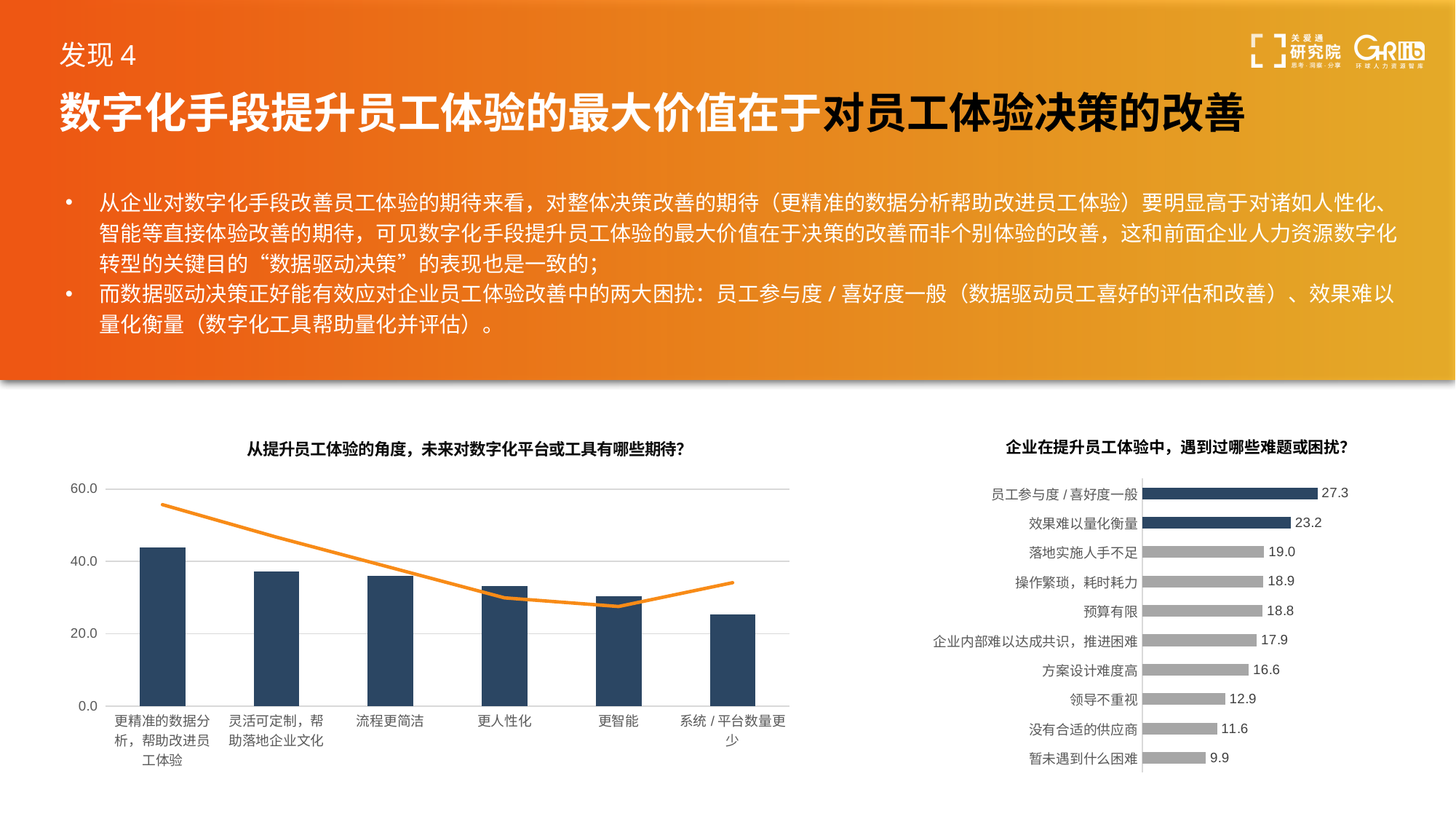
In the chart titled "企业在提升员工体验中，遇到过哪些难题或困扰?", what is the difference between 员工参与度 / 喜好度一般 and 效果难以量化衡量? 4.1 In the chart titled "企业在提升员工体验中，遇到过哪些难题或困扰?", what is the value for 预算有限? 18.8 In the chart titled "企业在提升员工体验中，遇到过哪些难题或困扰?", which category has the lowest value? 暂未遇到什么困难 In the chart titled "企业在提升员工体验中，遇到过哪些难题或困扰?", what is the value for 效果难以量化衡量? 23.2 In the chart titled "从提升员工体验的角度，未来对数字化平台或工具有哪些期待?", how many categories are shown on the x axis? 6 In the chart titled "从提升员工体验的角度，未来对数字化平台或工具有哪些期待?", which category has the shortest bar? 系统 / 平台数量更少 In the chart titled "从提升员工体验的角度，未来对数字化平台或工具有哪些期待?", do the bar values rise or fall from left to right? fall In the chart titled "企业在提升员工体验中，遇到过哪些难题或困扰?", which is larger: 领导不重视 or 没有合适的供应商? 领导不重视 In the chart titled "企业在提升员工体验中，遇到过哪些难题或困扰?", how many categories are shown? 10 In the chart titled "企业在提升员工体验中，遇到过哪些难题或困扰?", which category has the highest value? 员工参与度 / 喜好度一般 In the chart titled "从提升员工体验的角度，未来对数字化平台或工具有哪些期待?", which category has the tallest bar? 更精准的数据分析，帮助改进员工体验 In the chart titled "从提升员工体验的角度，未来对数字化平台或工具有哪些期待?", is the bar for 更精准的数据分析，帮助改进员工体验 greater or less than 40.0? greater